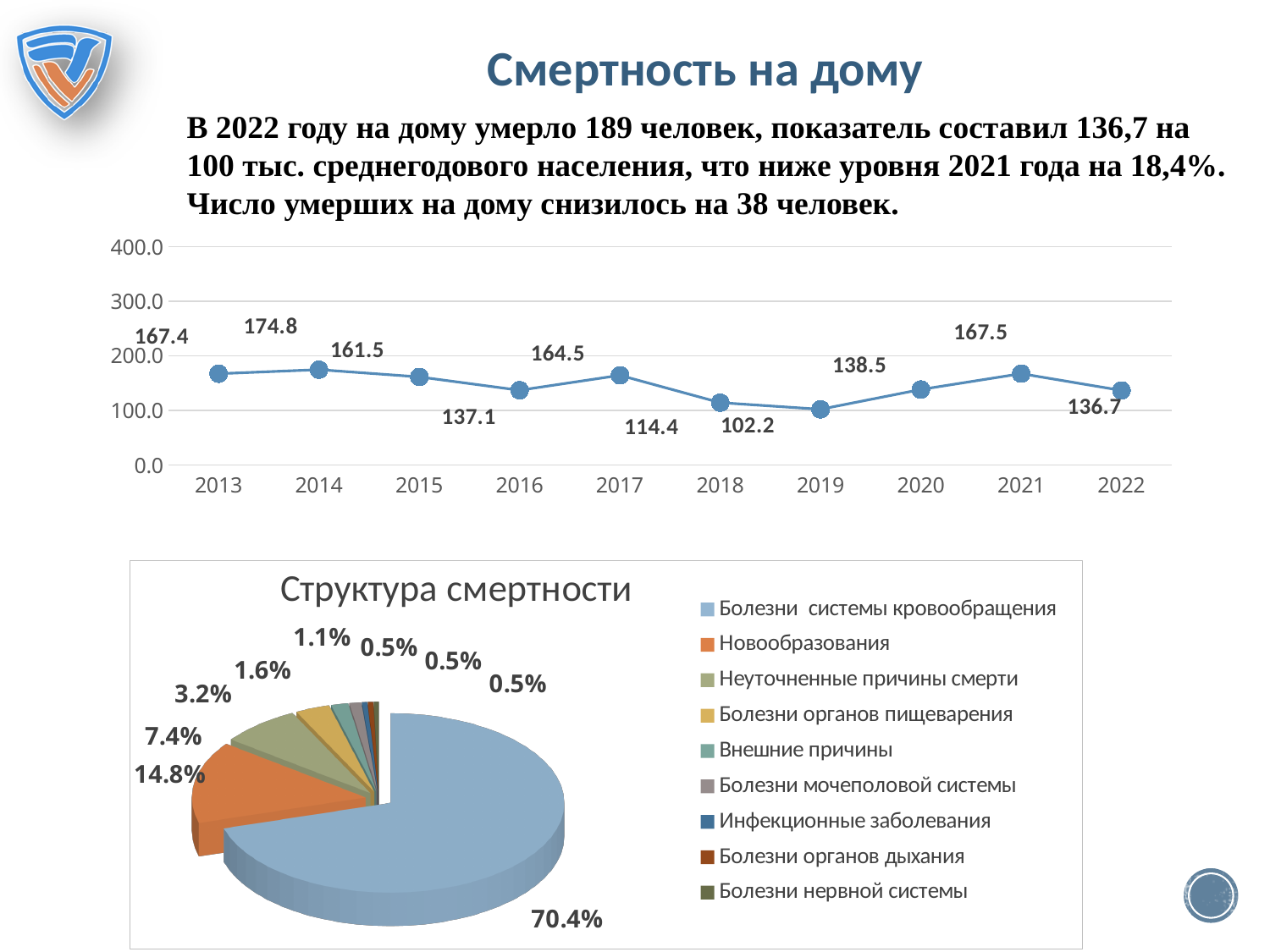
In the top line chart, which year has the highest value? 2014 In the pie chart 'Структура смертности', what share does 'Болезни системы кровообращения' have? 70.4% In the pie chart 'Структура смертности', what share does 'Новообразования' have? 14.8% In the top line chart, what is the value for 2014? 174.8 In the top line chart, does the value rise or fall from 2017 to 2019? fall In the top line chart, which year has the lowest value? 2019 In the top line chart, what is the difference between the values for 2021 and 2022? 30.8 What type of chart is the top chart on the slide? line chart In the top line chart, which is larger: the value for 2016 or the value for 2017? 2017 How many entries does the legend of the pie chart 'Структура смертности' list? 9 In the top line chart, how many years are plotted on the x axis? 10 In the top line chart, what is the value for 2019? 102.2